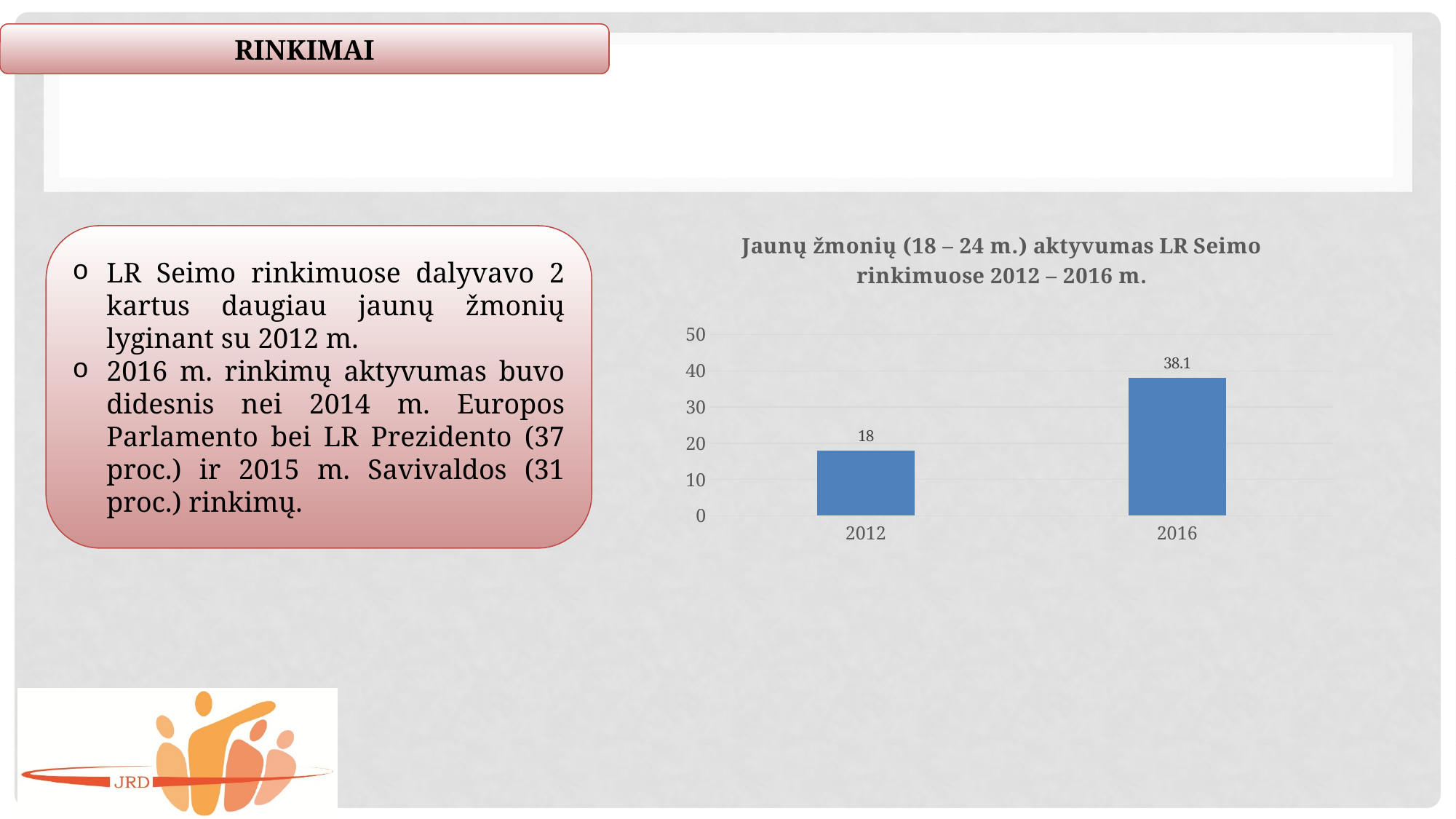
How many bars are shown in the chart? 2 What is the title of the chart? Jaunų žmonių (18 – 24 m.) aktyvumas LR Seimo rinkimuose 2012 – 2016 m. What kind of chart is shown on the slide? Bar chart Is the value for 2016 greater or less than 40? less What is the value for 2012? 18 What is the difference between the values for 2016 and 2012? 20.1 Is the value for 2016 larger than the value for 2012? Yes Which year has the lower value? 2012 Is the value for 2012 greater or less than 20? less Do the values rise or fall from 2012 to 2016? Rise What is the value for 2016? 38.1 Which year has the higher value? 2016